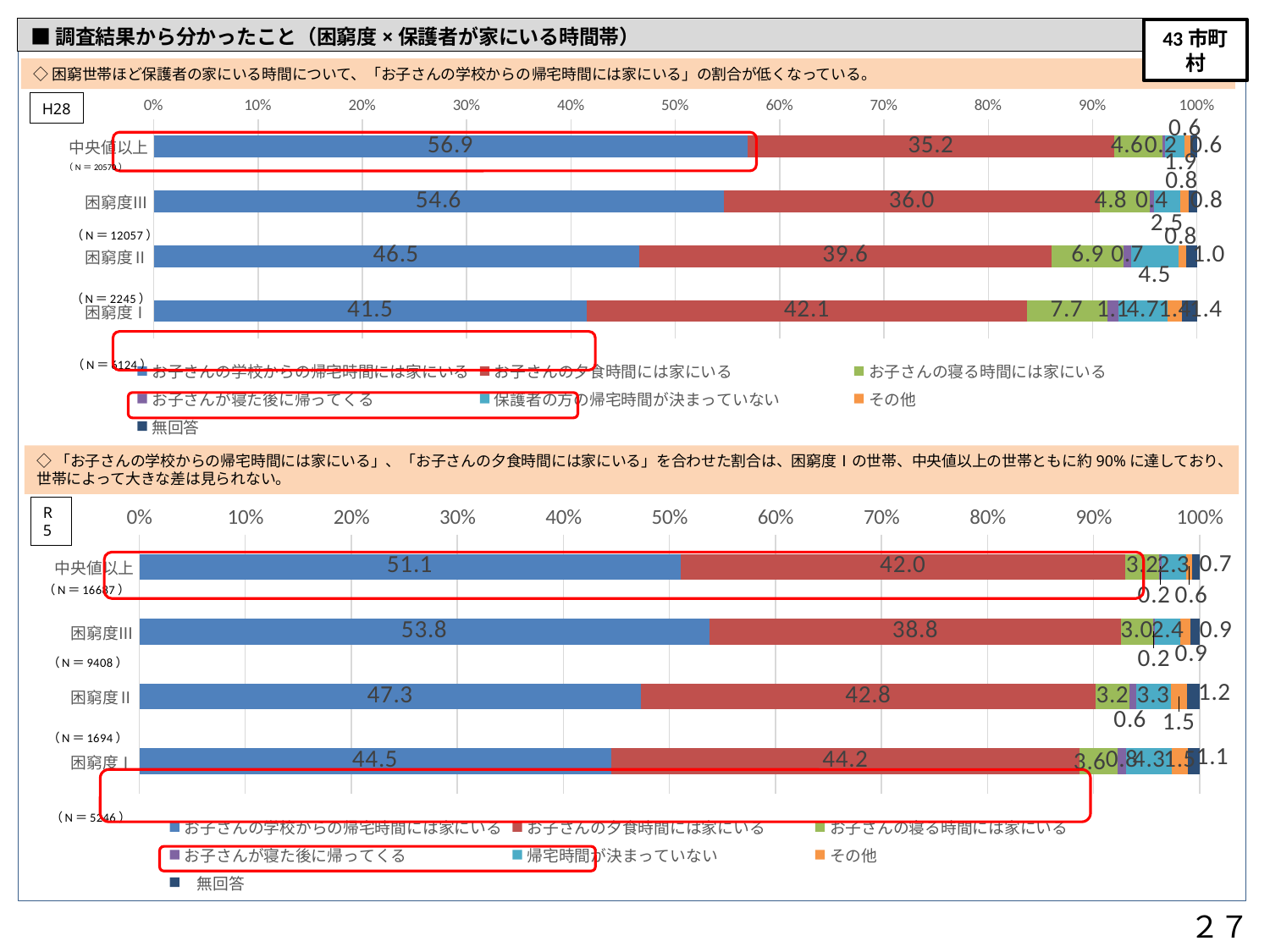
In the R5 chart (bottom), what is the value for 「お子さんの夕食時間には家にいる」 for 困窮度II? 42.8 In the R5 chart (bottom), which is larger for 困窮度I: 「お子さんの学校からの帰宅時間には家にいる」 or 「お子さんの夕食時間には家にいる」? お子さんの学校からの帰宅時間には家にいる In the H28 chart (top), which category has the highest value for 「お子さんの学校からの帰宅時間には家にいる」? 中央値以上 How many categories are shown in the R5 chart (bottom)? 4 In the R5 chart (bottom), which category has the highest value for 「お子さんの学校からの帰宅時間には家にいる」? 困窮度III In the H28 chart (top), what is the value for 「お子さんの夕食時間には家にいる」 for 困窮度I? 42.1 In the H28 chart (top), which category has the lowest value for 「お子さんの学校からの帰宅時間には家にいる」? 困窮度I What kind of chart is the H28 chart (top)? Stacked bar chart In the R5 chart (bottom), what is the value for 「お子さんの学校からの帰宅時間には家にいる」 for 困窮度III? 53.8 How many series does the legend of the H28 chart (top) list? 7 In the H28 chart (top), what is the value for 「お子さんの学校からの帰宅時間には家にいる」 for 中央値以上? 56.9 In the H28 chart (top), what is the difference between the 「お子さんの学校からの帰宅時間には家にいる」 values for 中央値以上 and 困窮度I? 15.4